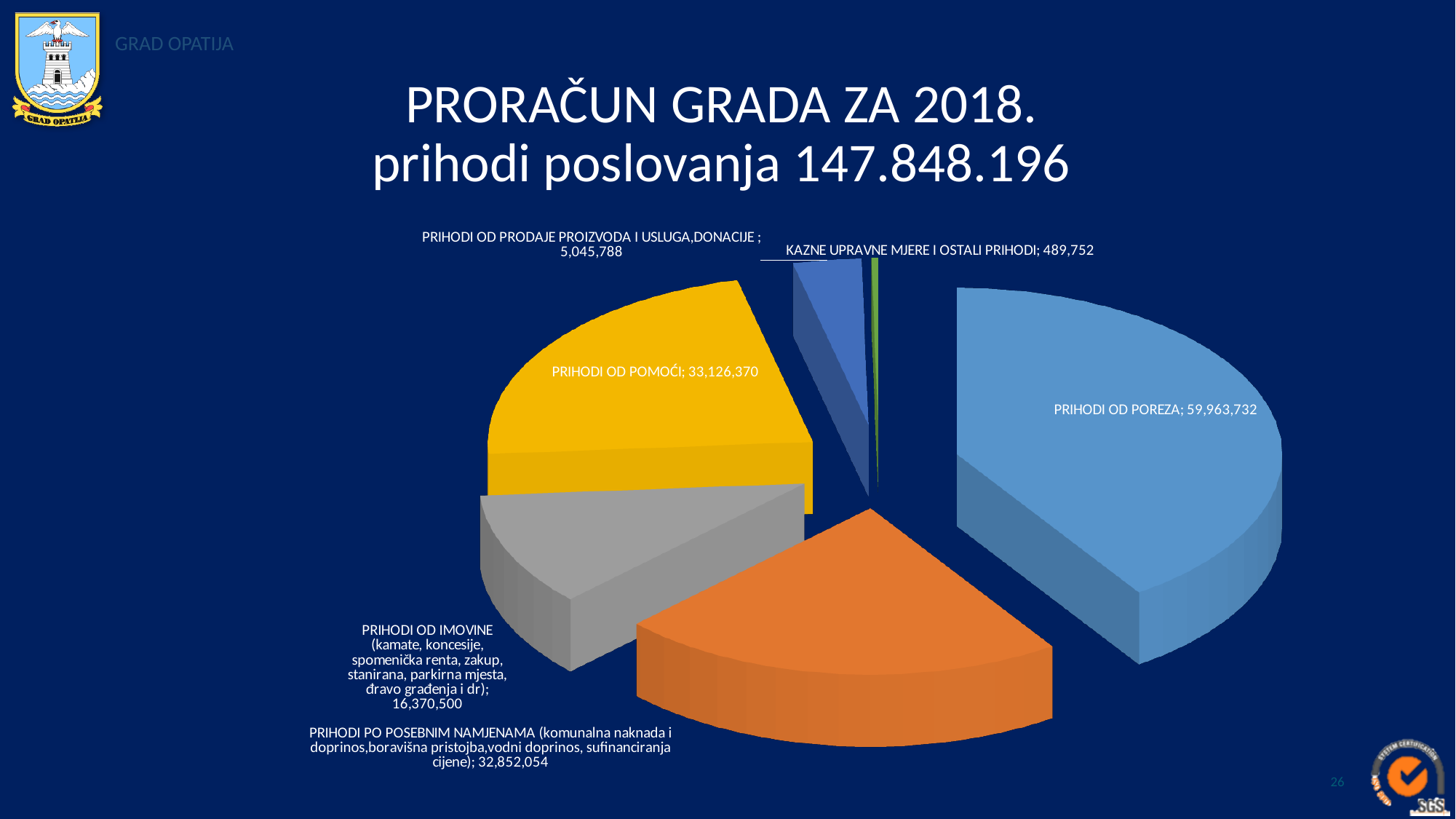
What value is shown for KAZNE UPRAVNE MJERE I OSTALI PRIHODI? 489,752 How many slices does the pie chart have? 6 What is the difference between PRIHODI OD POREZA and PRIHODI OD POMOĆI? 26,837,362 What is the value shown for PRIHODI OD POMOĆI? 33,126,370 Which category has the largest slice of the pie? PRIHODI OD POREZA Which category has the smallest slice of the pie? KAZNE UPRAVNE MJERE I OSTALI PRIHODI What colour is the PRIHODI OD POMOĆI slice? Yellow What is the value of the PRIHODI OD PRODAJE PROIZVODA I USLUGA,DONACIJE slice? 5,045,788 What kind of chart is shown on the slide? Pie chart What is the value of the PRIHODI OD POREZA slice? 59,963,732 Which is larger: PRIHODI OD POMOĆI or PRIHODI PO POSEBNIM NAMJENAMA? PRIHODI OD POMOĆI What share of the total 147.848.196 does PRIHODI OD POREZA represent, to the nearest whole percent? 41%